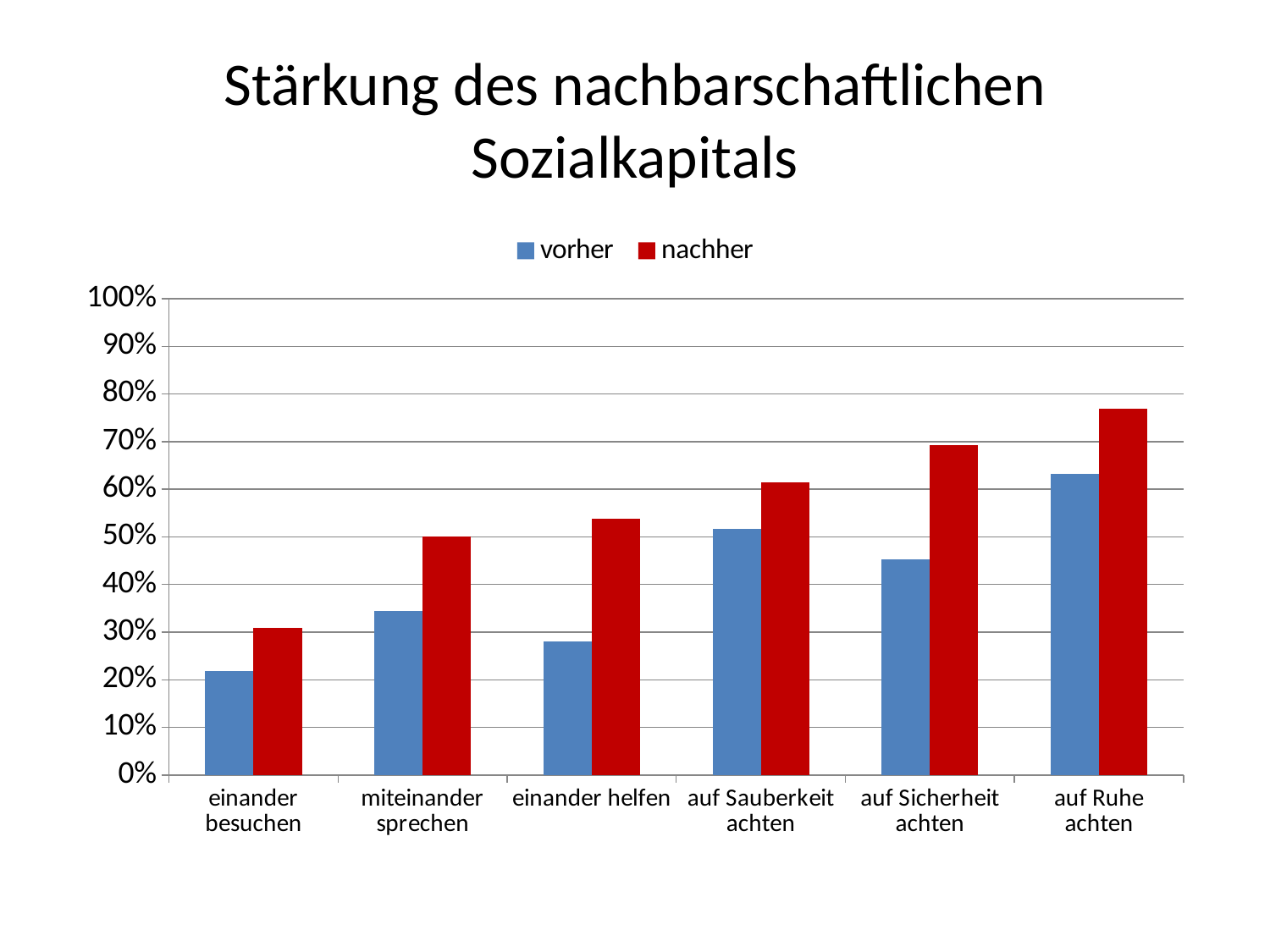
What kind of chart is shown on the slide? bar chart Is the 'nachher' value for 'auf Ruhe achten' greater or less than 70%? greater What colour are the 'nachher' bars? red Do the 'nachher' values rise or fall from left to right along the x axis? rise Is the 'nachher' value for 'auf Sicherheit achten' greater or less than 60%? greater For 'einander helfen', which is larger: the 'vorher' value or the 'nachher' value? nachher How many series does the legend list? 2 Is the 'vorher' value for 'einander besuchen' greater or less than 30%? less Which category has the lowest 'vorher' value? einander besuchen How many categories are shown on the x axis? 6 Which category has the highest 'nachher' value? auf Ruhe achten